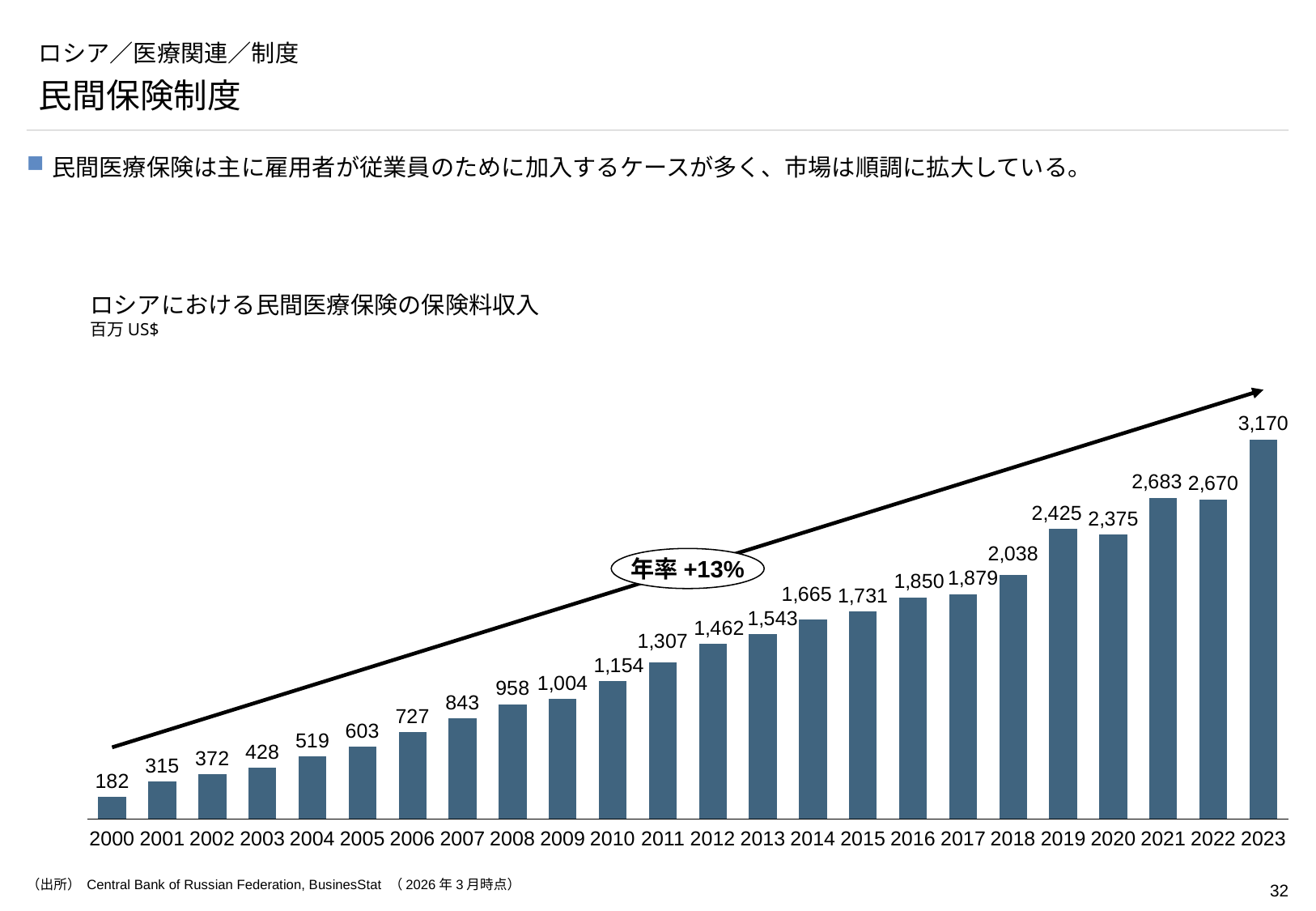
Do the values generally rise or fall from 2000 to 2023? Rise What is the value for 2012? 1,462 How many years are shown on the x axis? 24 What is the difference between the values for 2023 and 2022? 500 Which year has the lowest value? 2000 What is the value for 2000? 182 What kind of chart is this? Bar chart What is the value for 2023? 3,170 What unit is stated under the chart title? 百万 US$ Which year has the highest value? 2023 What annual growth rate is written in the oval annotation on the chart? 年率 +13% Which is larger, the value for 2019 or the value for 2020? 2019